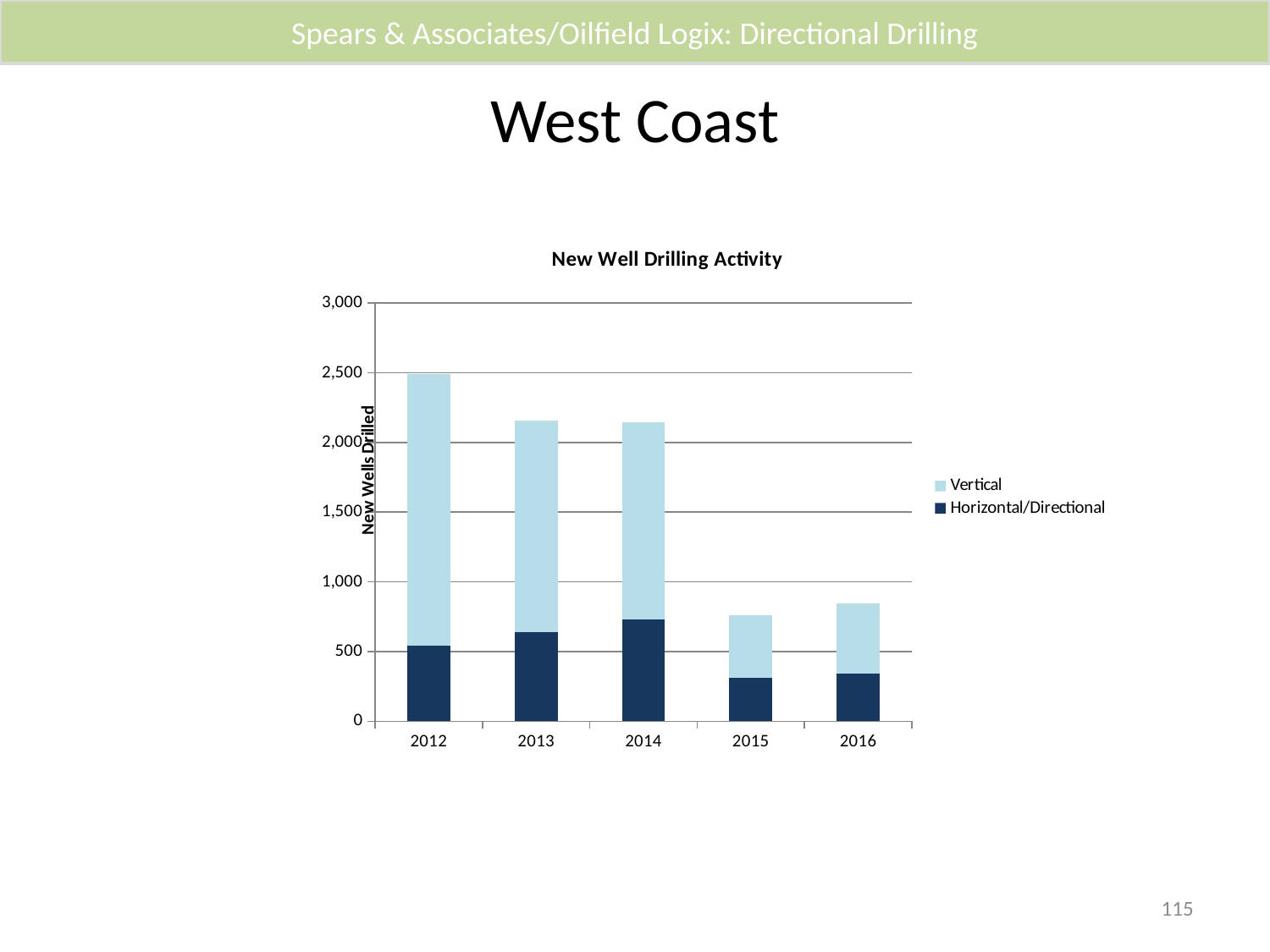
Which year has the highest total number of new wells drilled? 2012 What kind of chart is shown on the slide? Stacked bar chart Is the total value for 2015 greater or less than 1,000? less How many years are shown on the x axis? 5 Is the Horizontal/Directional value for 2014 greater or less than 500? greater How many series does the legend list? 2 Which year has a larger total of new wells drilled, 2012 or 2015? 2012 Is the Horizontal/Directional value for 2015 greater or less than 500? less Which year has the lowest total number of new wells drilled? 2015 Which year has the largest Horizontal/Directional value? 2014 Do the total new wells drilled rise or fall from 2012 to 2015? fall